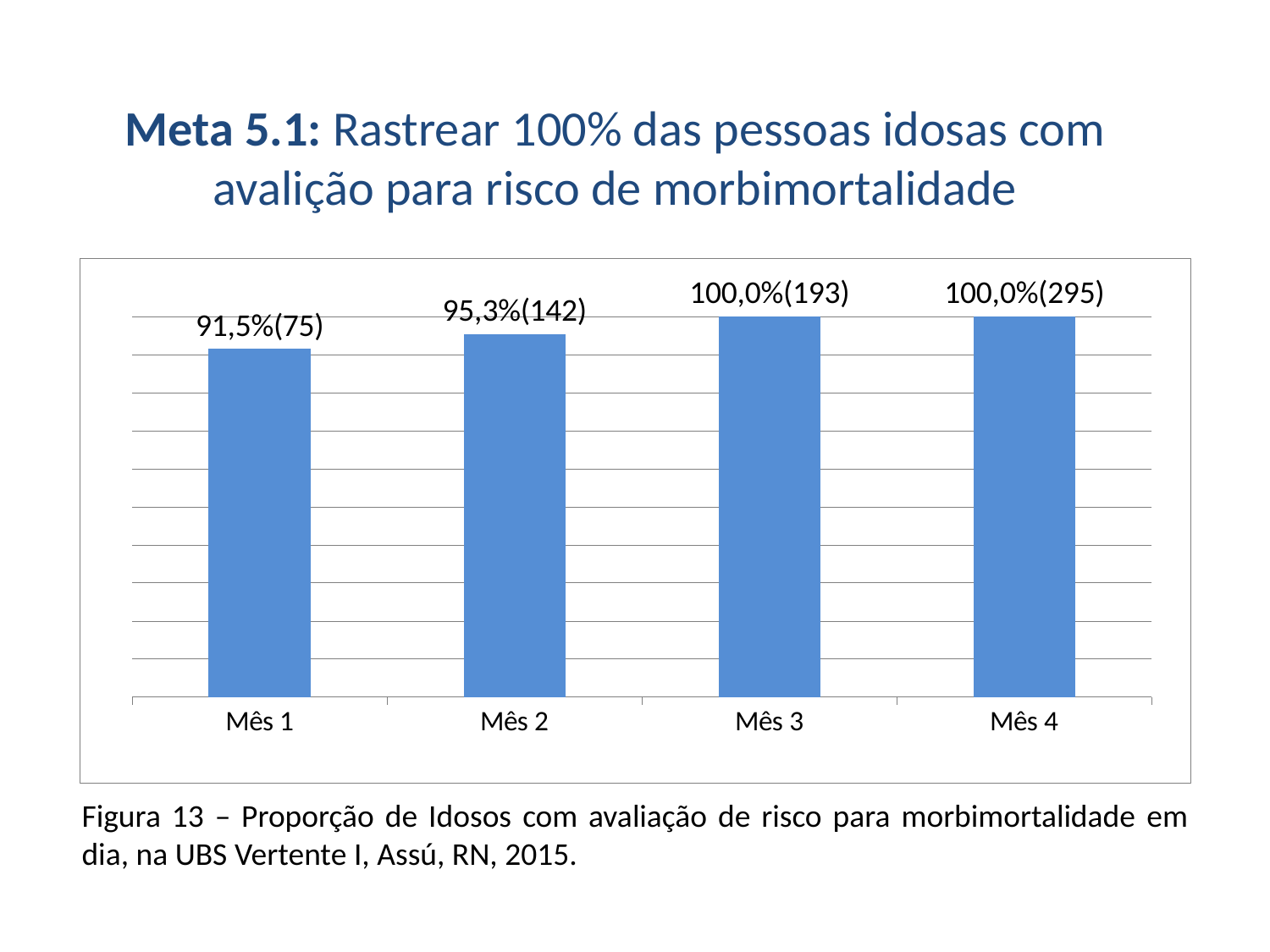
What is the data label shown for Mês 4? 100,0%(295) What percentage is shown for Mês 2? 95,3% What is the data label shown for Mês 2? 95,3%(142) Which month has the lowest value? Mês 1 What kind of chart is shown on the slide? Bar chart What is the data label shown for Mês 3? 100,0%(193) Which of Mês 1 and Mês 2 has the larger value? Mês 2 How many months (categories) are shown on the x axis? 4 What is the difference in percentage points between Mês 2 (95,3%) and Mês 1 (91,5%)? 3,8 What is the data label shown for Mês 1? 91,5%(75) What is the difference between the counts in parentheses for Mês 4 (295) and Mês 3 (193)? 102 Do the values rise or fall from Mês 1 to Mês 4? Rise